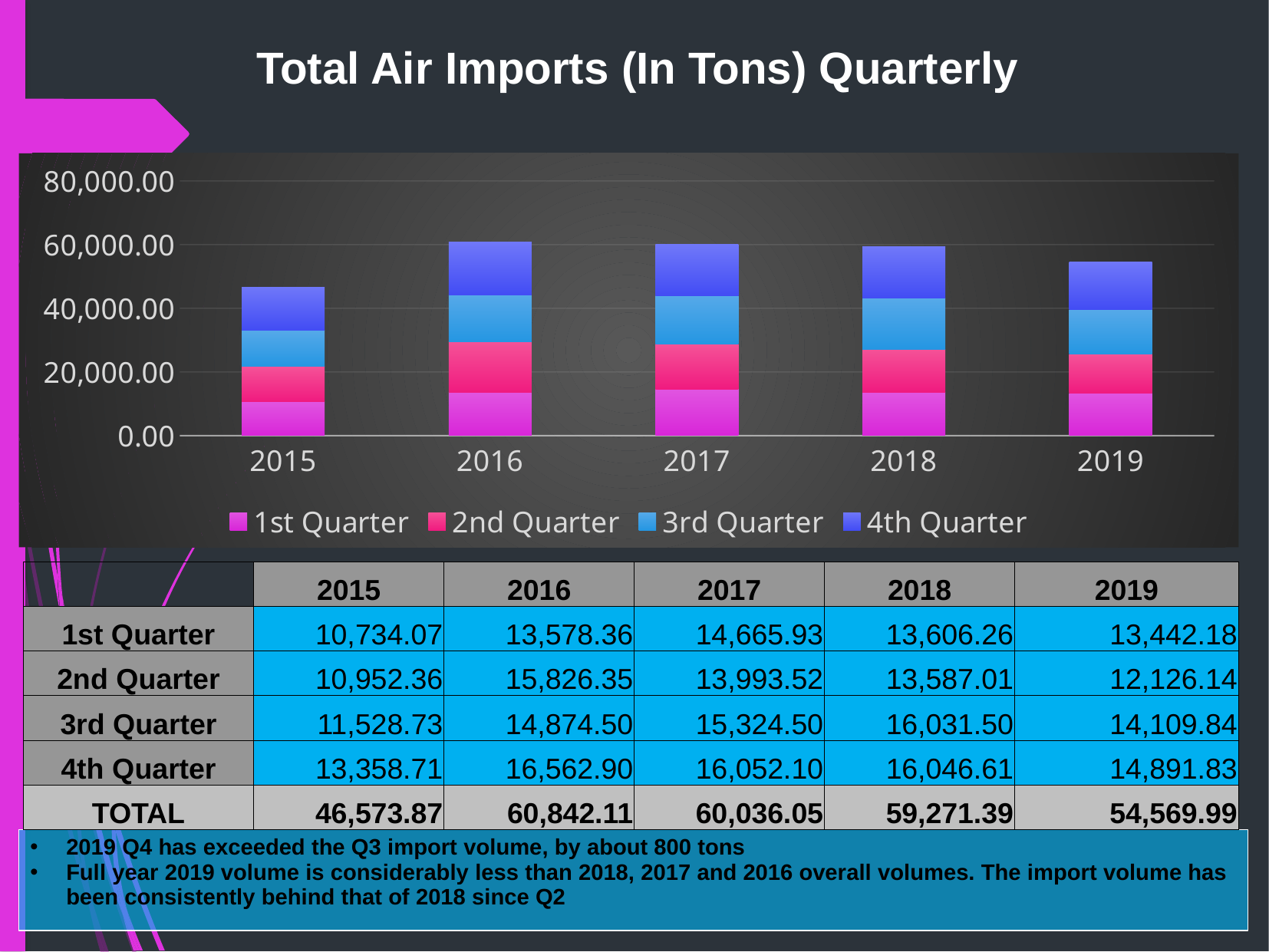
Which is larger, the 2nd Quarter value for 2016 or the 2nd Quarter value for 2017? 2016 How many series does the legend list? 4 Which year has the lowest total air imports? 2015 What is the 1st Quarter value for 2017? 14,665.93 Which year has the highest total air imports? 2016 What is the 4th Quarter value for 2016? 16,562.90 What is the difference between the 4th Quarter and 3rd Quarter values for 2019? 781.99 Is the total stacked bar for 2015 greater or less than 60,000.00? less How many years are shown on the x axis of the chart? 5 What kind of chart is shown on the slide? Stacked bar chart What is the difference between the total for 2016 and the total for 2015? 14,268.24 What is the total air import volume for 2019? 54,569.99